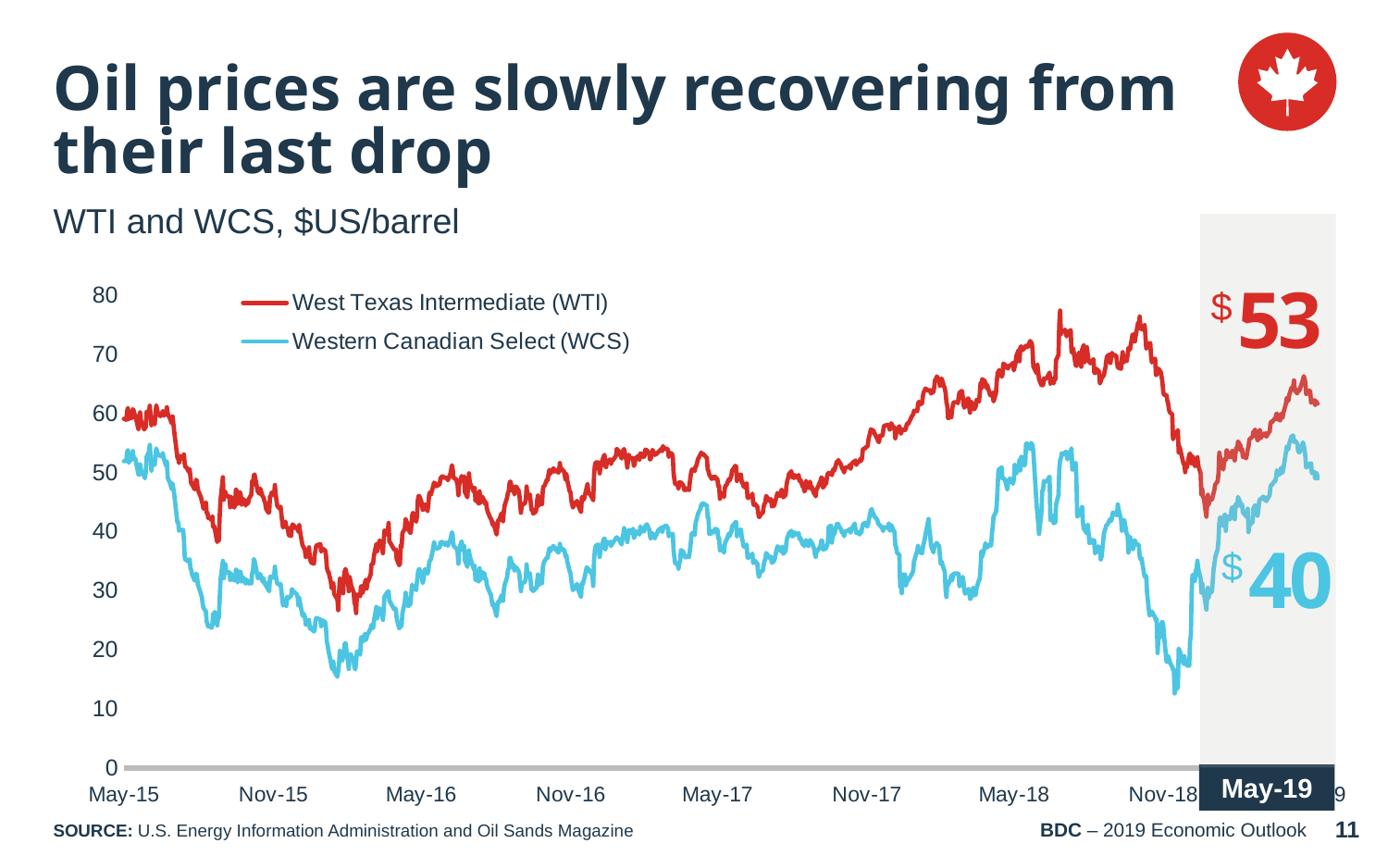
How many series does the legend list? 2 What kind of chart is shown on the slide? Line chart What is the WTI price shown for May-19? $53 What unit are the prices on the chart expressed in? $US/barrel What is the WCS price shown for May-19? $40 Is the WCS value at May-15 greater or less than 40? greater Is the lowest WCS value in the period around Nov-18 greater or less than 20? less What colour is the line for West Texas Intermediate (WTI)? Red In May-19, which series has the higher price, WTI or WCS? WTI Is the highest WTI value reached in 2018 greater or less than 70? greater What is the difference between the WTI and WCS prices shown for May-19? $13